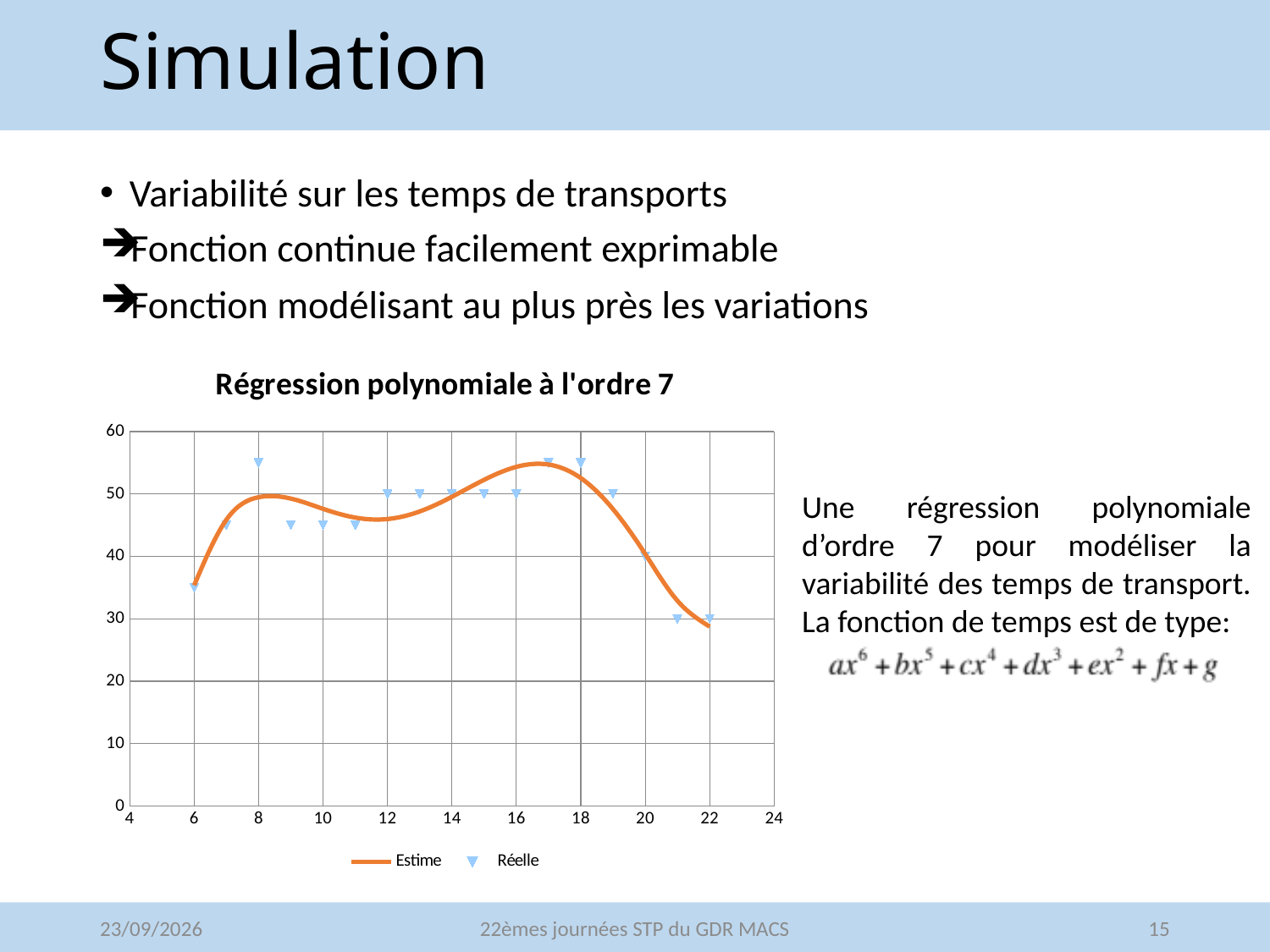
What is the title of the chart? Régression polynomiale à l'ordre 7 Which is larger, the Réelle value at x = 8 or the Réelle value at x = 21? x = 8 Does the Estime curve rise or fall between x = 6 and x = 8? rise Is the Réelle value at x = 6 greater or less than 40? less Is the Réelle value at x = 8 greater or less than 50? greater What kind of chart is shown on the slide? line chart Is the Réelle value at x = 10 greater or less than 50? less Does the Estime curve rise or fall between x = 18 and x = 22? fall How many series does the chart legend list? 2 What are the names of the two series in the chart legend? Estime and Réelle